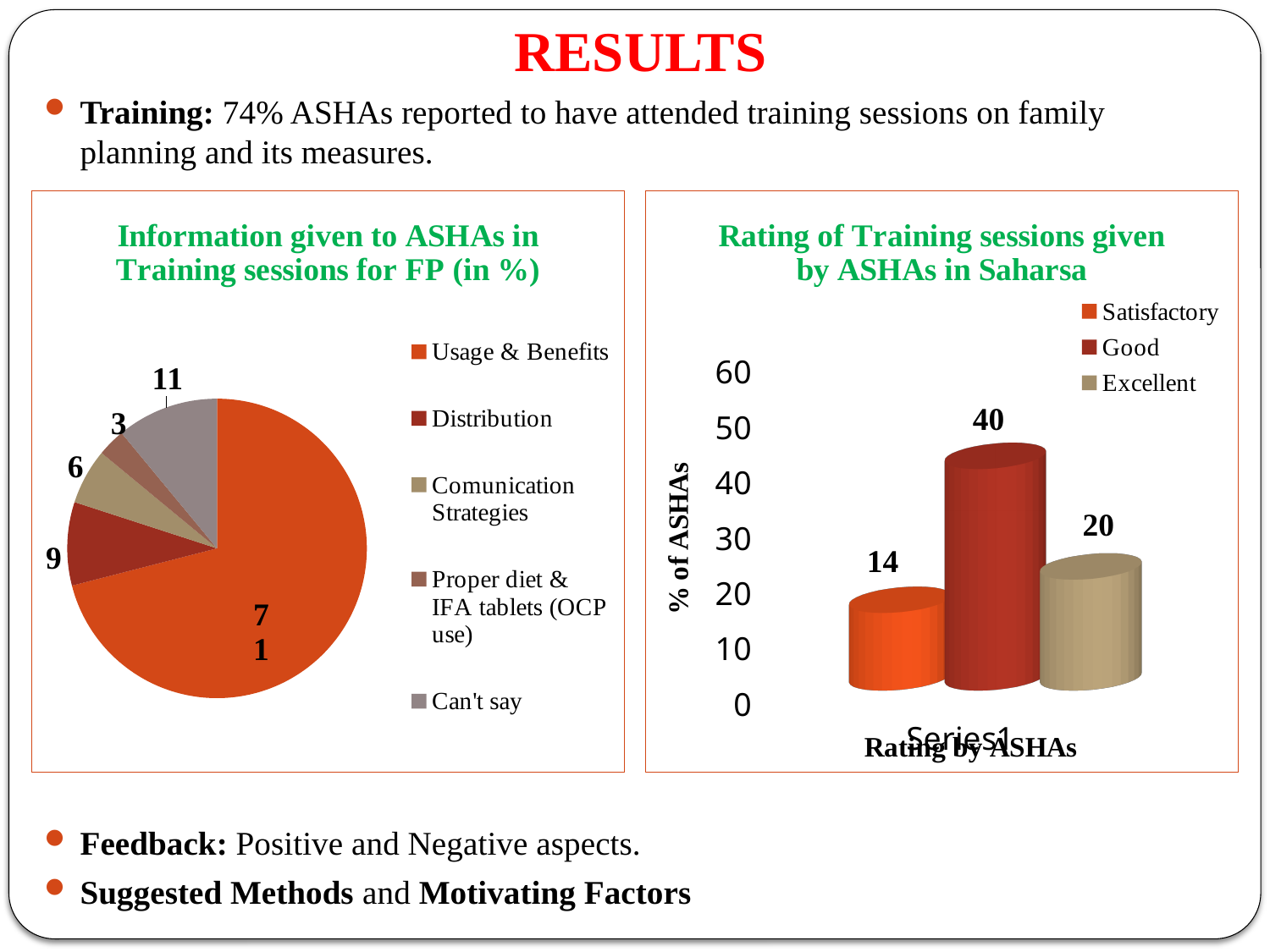
In the bar chart 'Rating of Training sessions given by ASHAs in Saharsa', what is the value for Satisfactory? 14 What type of chart is 'Rating of Training sessions given by ASHAs in Saharsa'? Bar chart In the pie chart 'Information given to ASHAs in Training sessions for FP (in %)', what is the value for Usage & Benefits? 71 In the bar chart 'Rating of Training sessions given by ASHAs in Saharsa', which rating has the highest value? Good In the pie chart 'Information given to ASHAs in Training sessions for FP (in %)', which is larger: Can't say or Distribution? Can't say In the bar chart 'Rating of Training sessions given by ASHAs in Saharsa', what is the value for Good? 40 In the pie chart 'Information given to ASHAs in Training sessions for FP (in %)', what is the value for Can't say? 11 In the pie chart 'Information given to ASHAs in Training sessions for FP (in %)', what is the difference between Distribution and Comunication Strategies? 3 In the bar chart 'Rating of Training sessions given by ASHAs in Saharsa', what is the difference between Good and Excellent? 20 In the bar chart 'Rating of Training sessions given by ASHAs in Saharsa', how many series does the legend list? 3 In the pie chart 'Information given to ASHAs in Training sessions for FP (in %)', which category has the smallest slice? Proper diet & IFA tablets (OCP use) In the pie chart 'Information given to ASHAs in Training sessions for FP (in %)', how many slices are there? 5